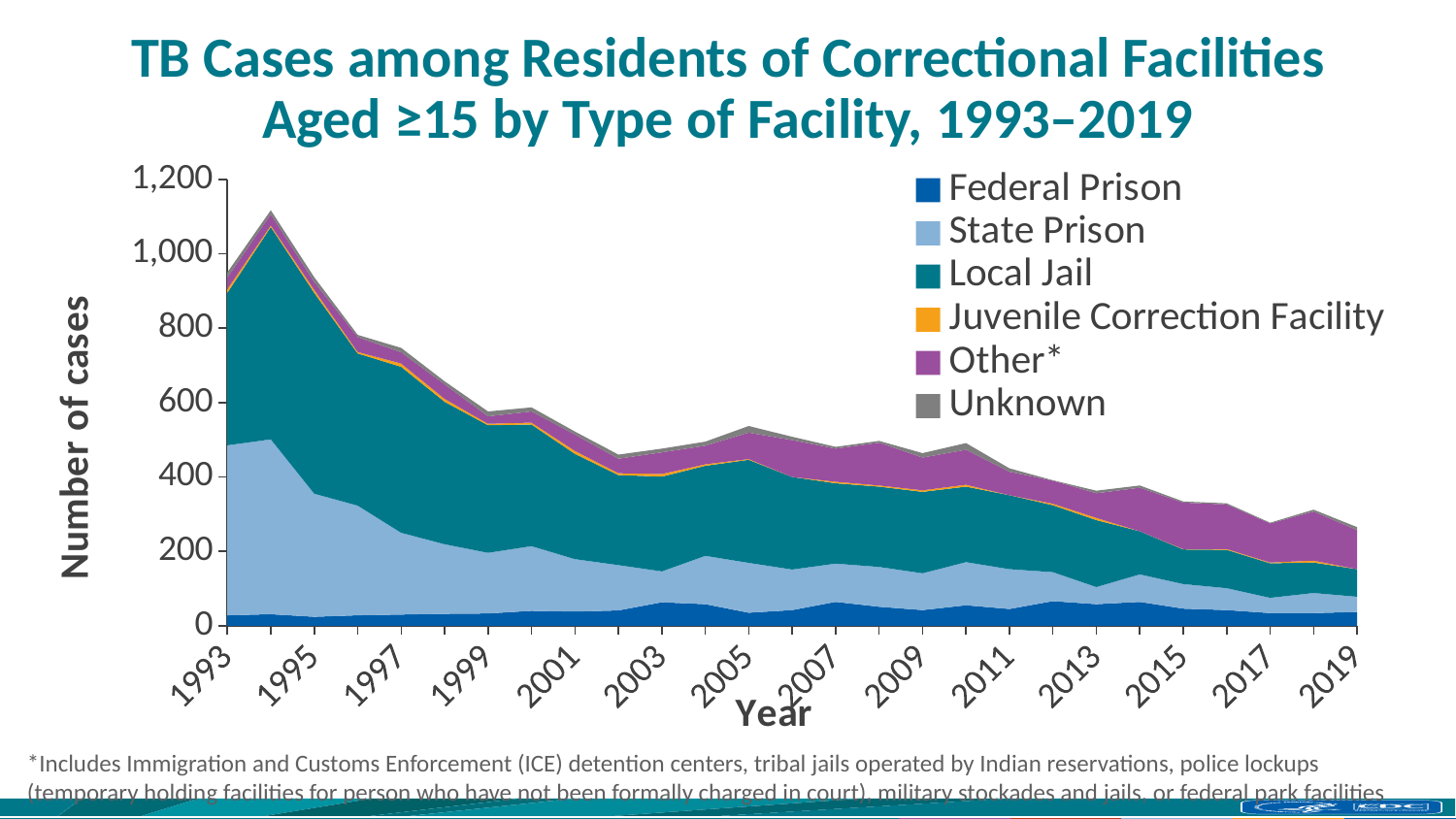
Is the total number of cases in 2019 greater or less than 400? less Does the total number of TB cases generally rise or fall from 1993 to 2019? Fall How many series does the legend list? 6 Is the total number of cases in 2003 greater or less than 600? less What kind of chart is shown on the slide? Stacked area chart Is the total number of cases in 1993 greater or less than 800? greater What is the label on the y axis? Number of cases Which series is plotted at the bottom of the stacked areas? Federal Prison How many years are plotted along the x axis, from 1993 to 2019? 27 Which year has the larger total number of cases, 1995 or 2005? 1995 In which year is the total number of cases highest? 1994